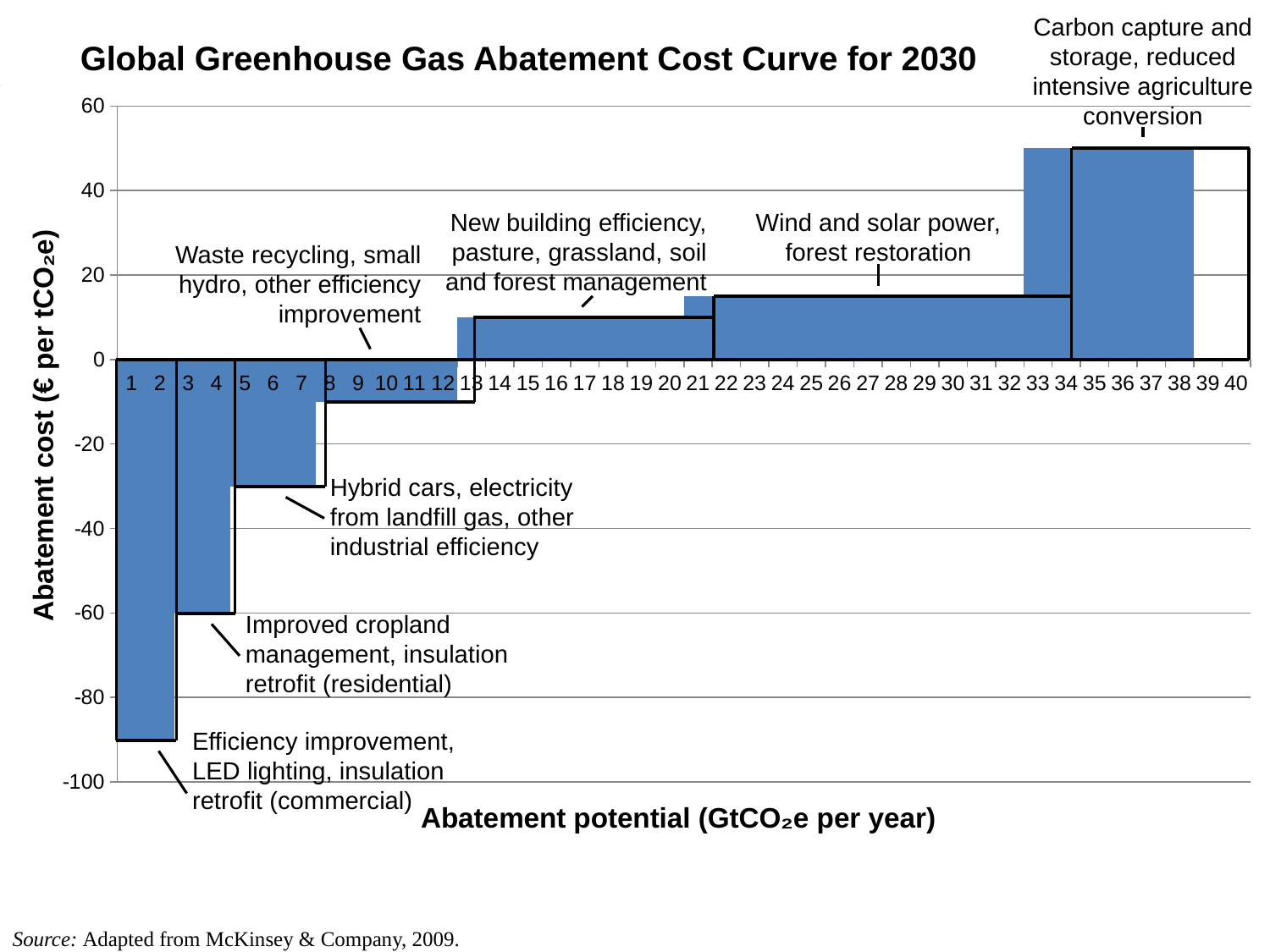
What kind of chart is shown on the slide? Bar chart Which measure has the highest abatement cost? Carbon capture and storage, reduced intensive agriculture conversion What is the abatement cost for Improved cropland management, insulation retrofit (residential)? -60 Do the abatement costs rise or fall as abatement potential increases along the x axis? Rise Is the abatement cost for Carbon capture and storage, reduced intensive agriculture conversion greater or less than 40? greater Is the abatement cost for Efficiency improvement, LED lighting, insulation retrofit (commercial) greater or less than -80? less Which measure has the lowest abatement cost? Efficiency improvement, LED lighting, insulation retrofit (commercial) What is the title of the chart? Global Greenhouse Gas Abatement Cost Curve for 2030 How many labelled abatement measures are shown on the chart? 7 Is the abatement cost for Hybrid cars, electricity from landfill gas, other industrial efficiency greater or less than -20? less Which has the higher abatement cost: Waste recycling, small hydro, other efficiency improvement, or Hybrid cars, electricity from landfill gas, other industrial efficiency? Waste recycling, small hydro, other efficiency improvement